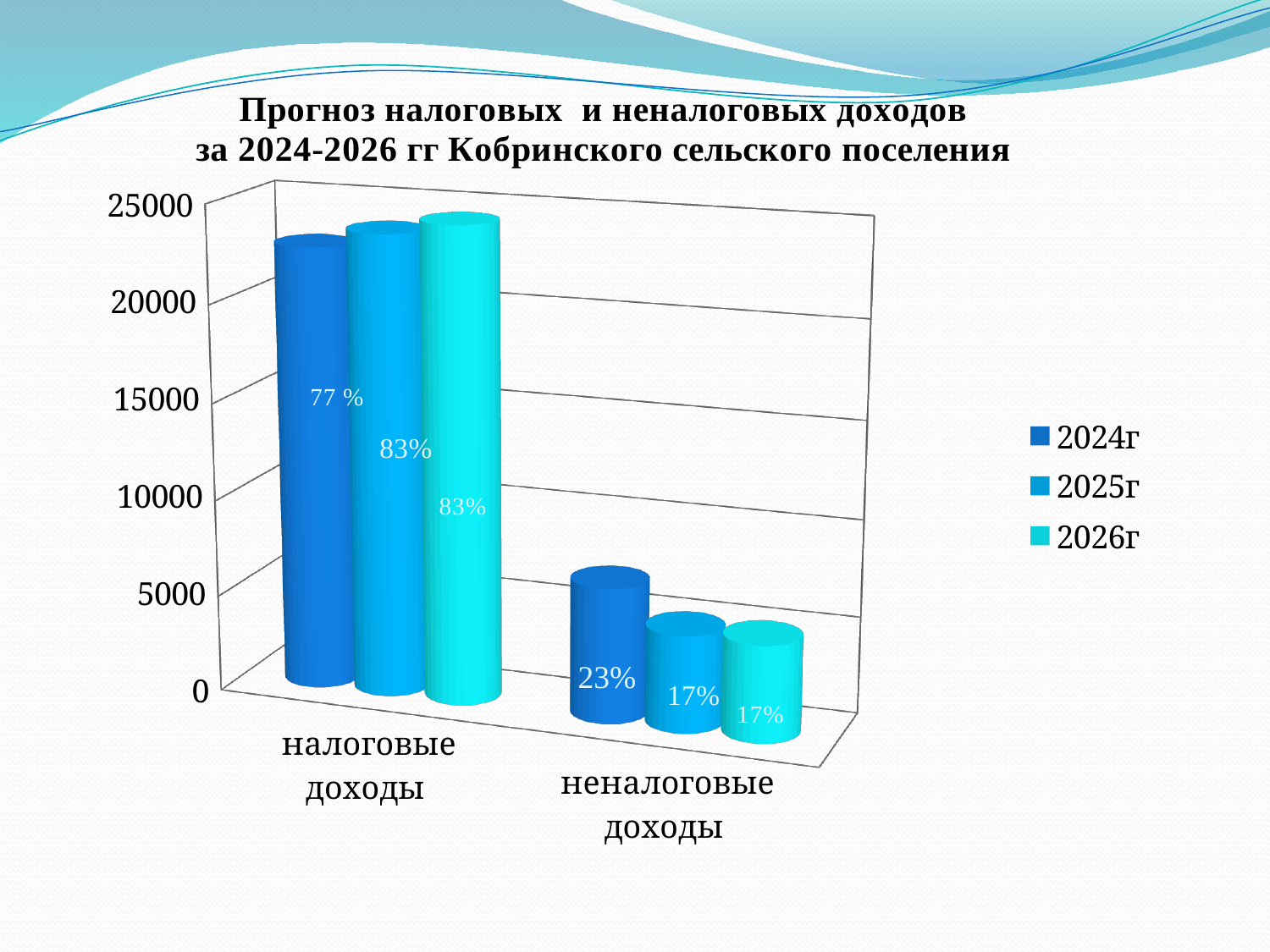
What data label is shown on the 2025г bar for налоговые доходы? 83% Which category has the higher values in every year, налоговые доходы or неналоговые доходы? налоговые доходы Is the value for налоговые доходы in 2024г greater or less than 20000? greater How many categories are shown on the x axis? 2 Do the values for налоговые доходы rise or fall from 2024г to 2026г? rise What data label is shown on the 2024г bar for налоговые доходы? 77 % Which years are listed in the chart legend? 2024г, 2025г, 2026г What kind of chart is shown on the slide? bar chart Is the value for неналоговые доходы in 2026г greater or less than 10000? less How many series does the legend list? 3 What data label is shown on the 2024г bar for неналоговые доходы? 23% What data label is shown on the 2026г bar for неналоговые доходы? 17%